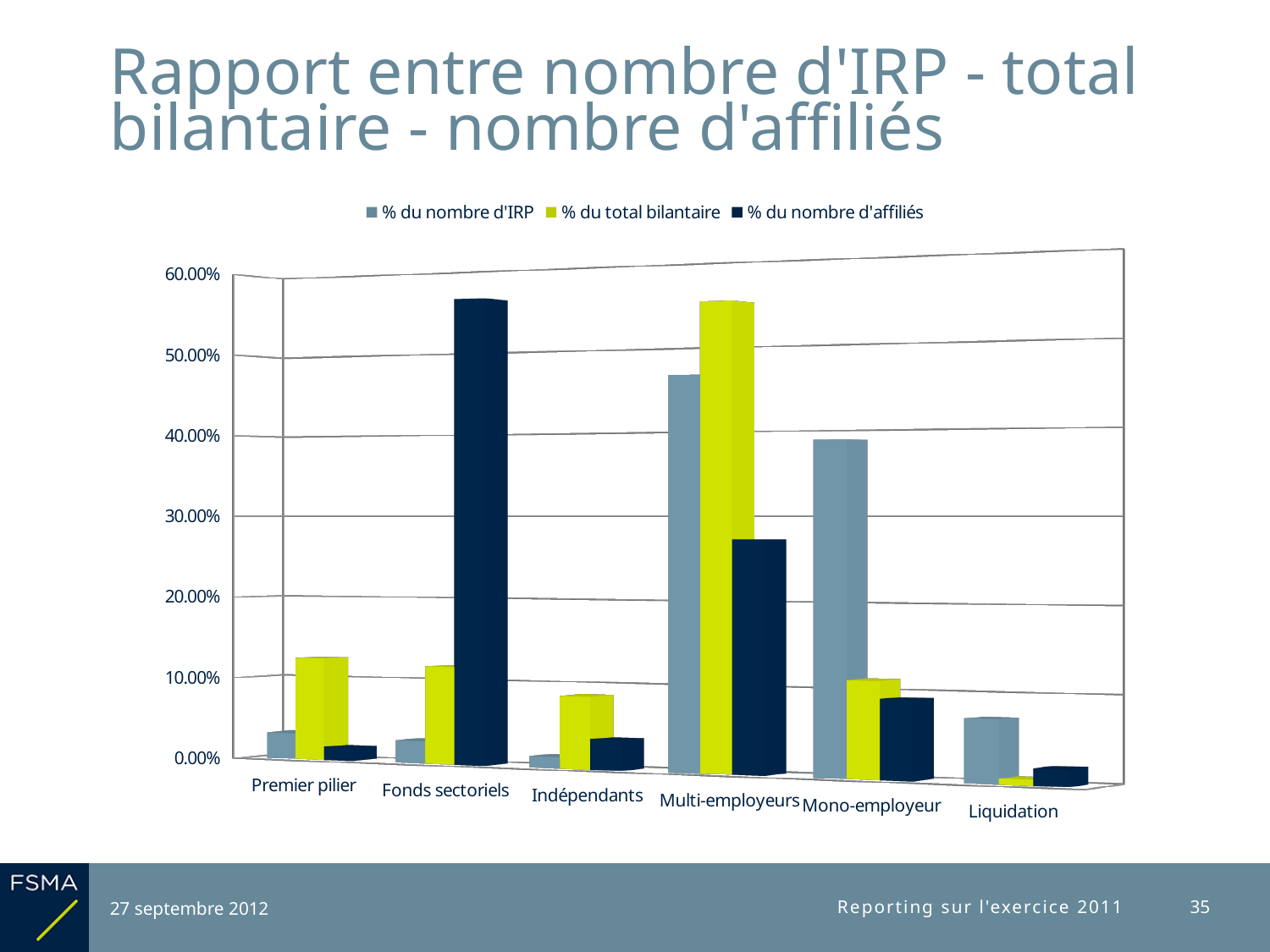
Is the value for '% du nombre d'IRP' for Multi-employeurs greater or less than 40.00%? greater Which category has the highest value for '% du total bilantaire'? Multi-employeurs Which series is shown in yellow-green in the legend? % du total bilantaire How many series does the legend list? 3 What kind of chart is shown on the slide? bar chart For Multi-employeurs, which is larger: '% du total bilantaire' or '% du nombre d'affiliés'? % du total bilantaire How many categories are shown on the x axis? 6 Which category has the highest value for '% du nombre d'affiliés'? Fonds sectoriels Which category has the lowest value for '% du nombre d'IRP'? Indépendants Is the value for '% du nombre d'affiliés' for Fonds sectoriels greater or less than 50.00%? greater Is the value for '% du nombre d'IRP' for Mono-employeur greater or less than 30.00%? greater Which category has the highest value for '% du nombre d'IRP'? Multi-employeurs